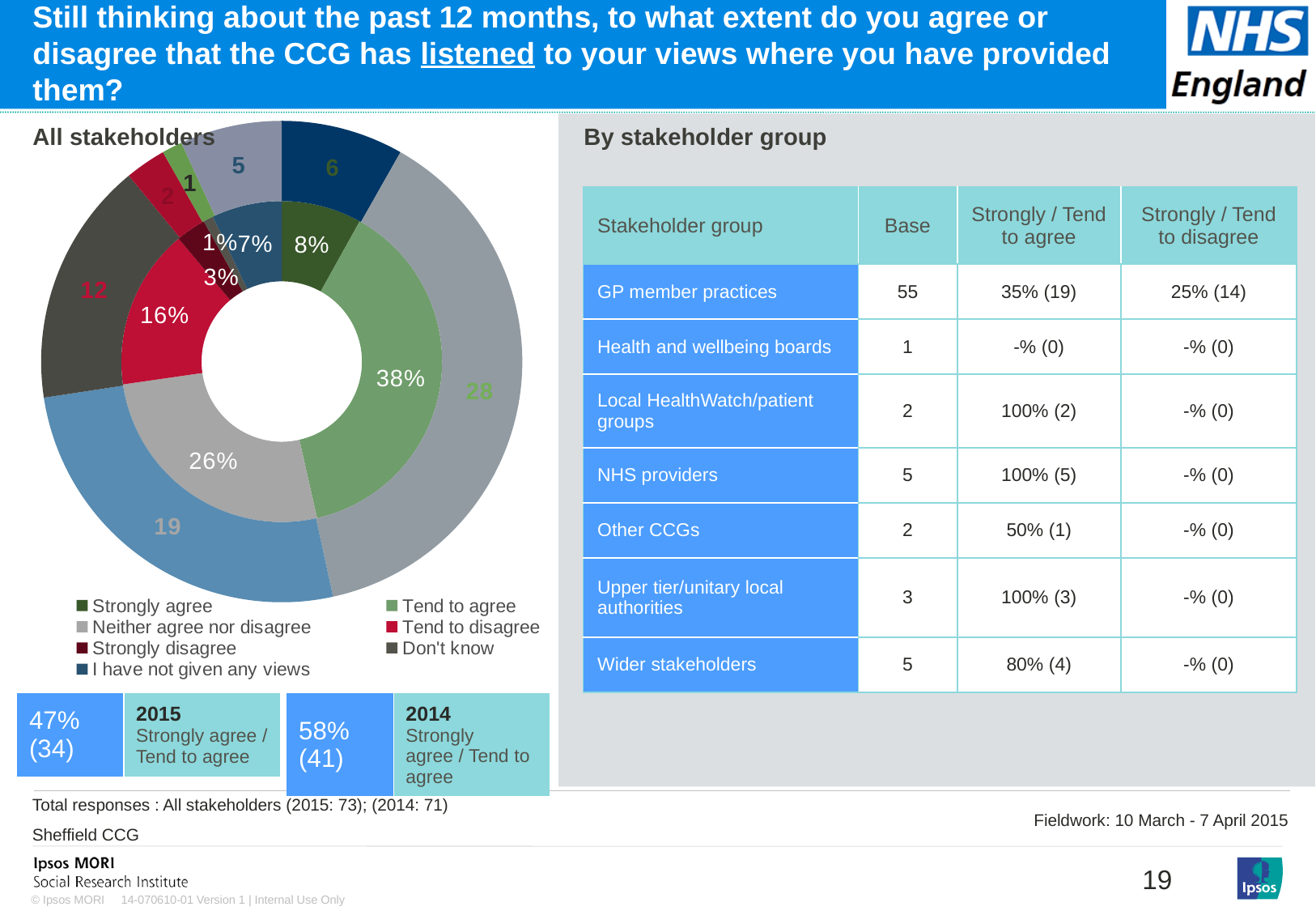
What percentage of all stakeholders said they tend to agree that the CCG has listened to their views? 38% How many percentage points higher is 'Tend to agree' than 'Neither agree nor disagree'? 12 How many response categories does the legend of the 'All stakeholders' chart list? 7 Which response category has the smallest share of all stakeholders? Don't know What percentage of all stakeholders strongly agree? 8% What percentage of all stakeholders neither agree nor disagree? 26% What percentage of all stakeholders said they have not given any views? 7% What percentage of all stakeholders tend to disagree? 16% What colour represents 'Tend to agree' in the 'All stakeholders' chart? Green What type of chart is used to show the 'All stakeholders' results? Doughnut (pie) chart Which is larger among all stakeholders: the share who tend to disagree or the share who strongly agree? Tend to disagree Which response category has the largest share of all stakeholders? Tend to agree